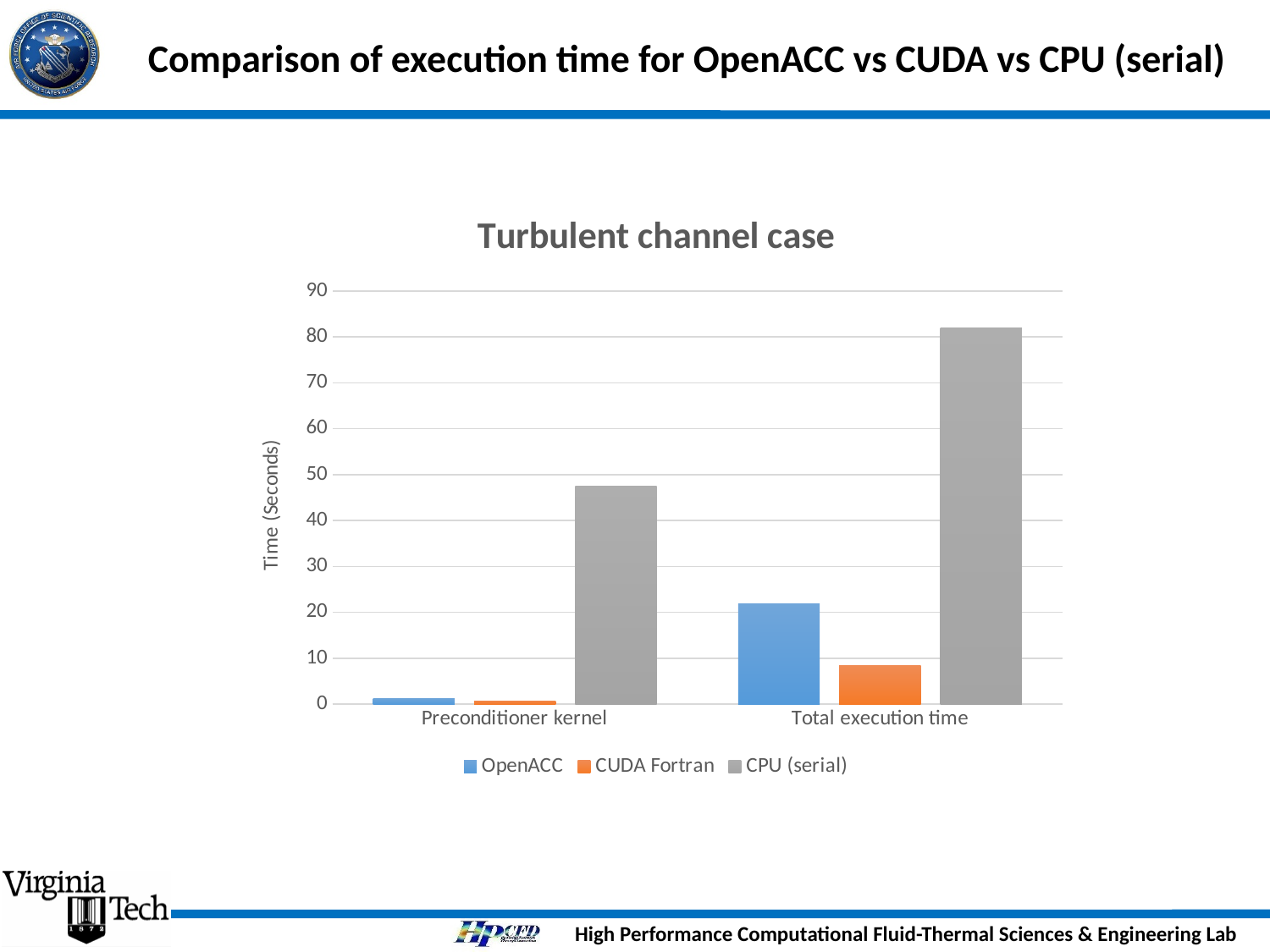
Which series has the highest value for Total execution time? CPU (serial) Which is larger for Total execution time: OpenACC or CUDA Fortran? OpenACC What type of chart is shown on the slide? bar chart How many series does the legend list? 3 How many categories are shown on the x axis? 2 What is the label of the y axis? Time (Seconds) Is the OpenACC value for Total execution time greater or less than 20? greater What is the title of the chart? Turbulent channel case Is the CPU (serial) value for Total execution time greater or less than 80? greater Which series has the lowest value for Total execution time? CUDA Fortran Is the CPU (serial) value for Preconditioner kernel greater or less than 50? less Which series has the highest value for Preconditioner kernel? CPU (serial)